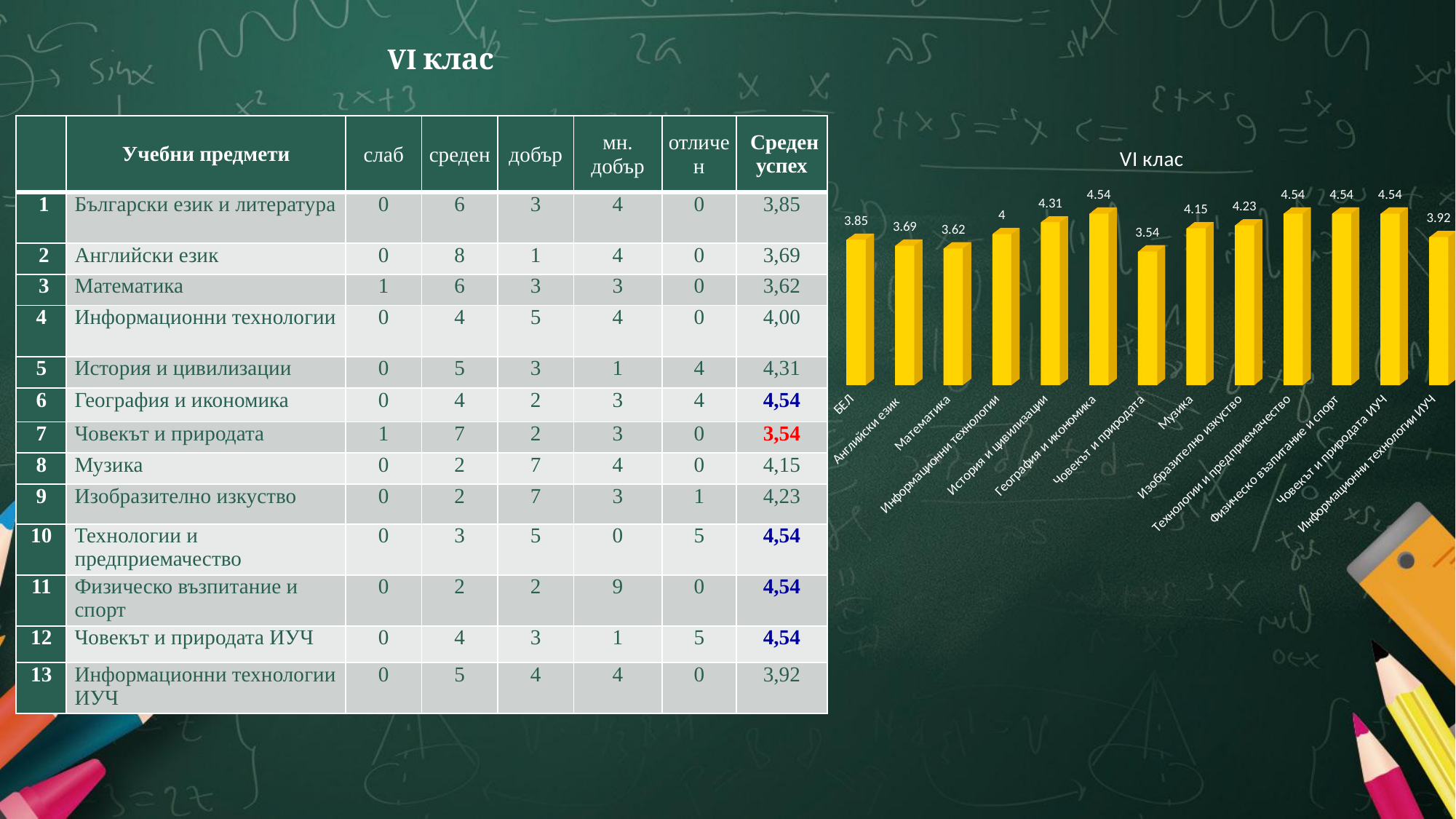
What is the title of the chart? VI клас What is the value shown for Информационни технологии ИУЧ in the chart? 3.92 What colour are the bars in the chart? yellow What is the value shown for Математика in the chart? 3.62 How many bars does the chart have? 13 What type of chart is shown on the slide? bar chart What is the value shown for История и цивилизации in the chart? 4.31 What is the highest value shown in the chart? 4.54 Which has a larger value, Английски език or Изобразително изкуство? Изобразително изкуство Which category has the lowest value in the chart? Човекът и природата What is the value shown for Музика in the chart? 4.15 What is the difference between the values for География и икономика and Човекът и природата? 1